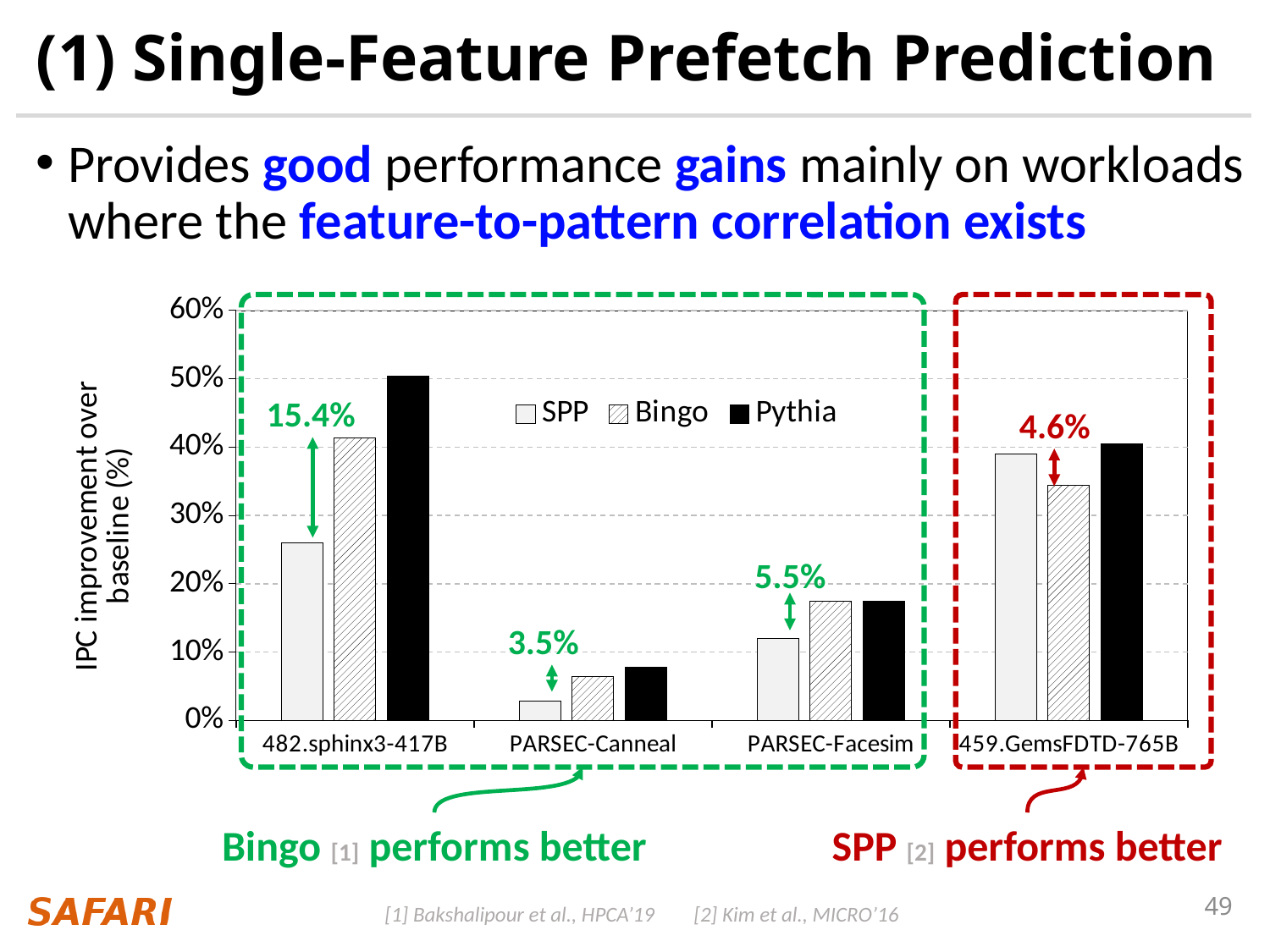
How many workload categories are shown on the x axis of the chart? 4 What is the label of the chart's vertical axis? IPC improvement over baseline (%) What difference between Bingo and SPP is annotated for 482.sphinx3-417B? 15.4% What difference between Bingo and SPP is annotated for PARSEC-Canneal? 3.5% Is the SPP value for 482.sphinx3-417B greater or less than 20%? greater For which workload is the SPP bar the lowest? PARSEC-Canneal For which workload is the Pythia bar the highest? 482.sphinx3-417B How many series does the chart's legend list? 3 What kind of chart is shown on the slide? bar chart For 459.GemsFDTD-765B, which is larger, the SPP bar or the Bingo bar? SPP What are the three series named in the chart's legend? SPP, Bingo, Pythia What difference between SPP and Bingo is annotated for 459.GemsFDTD-765B? 4.6%